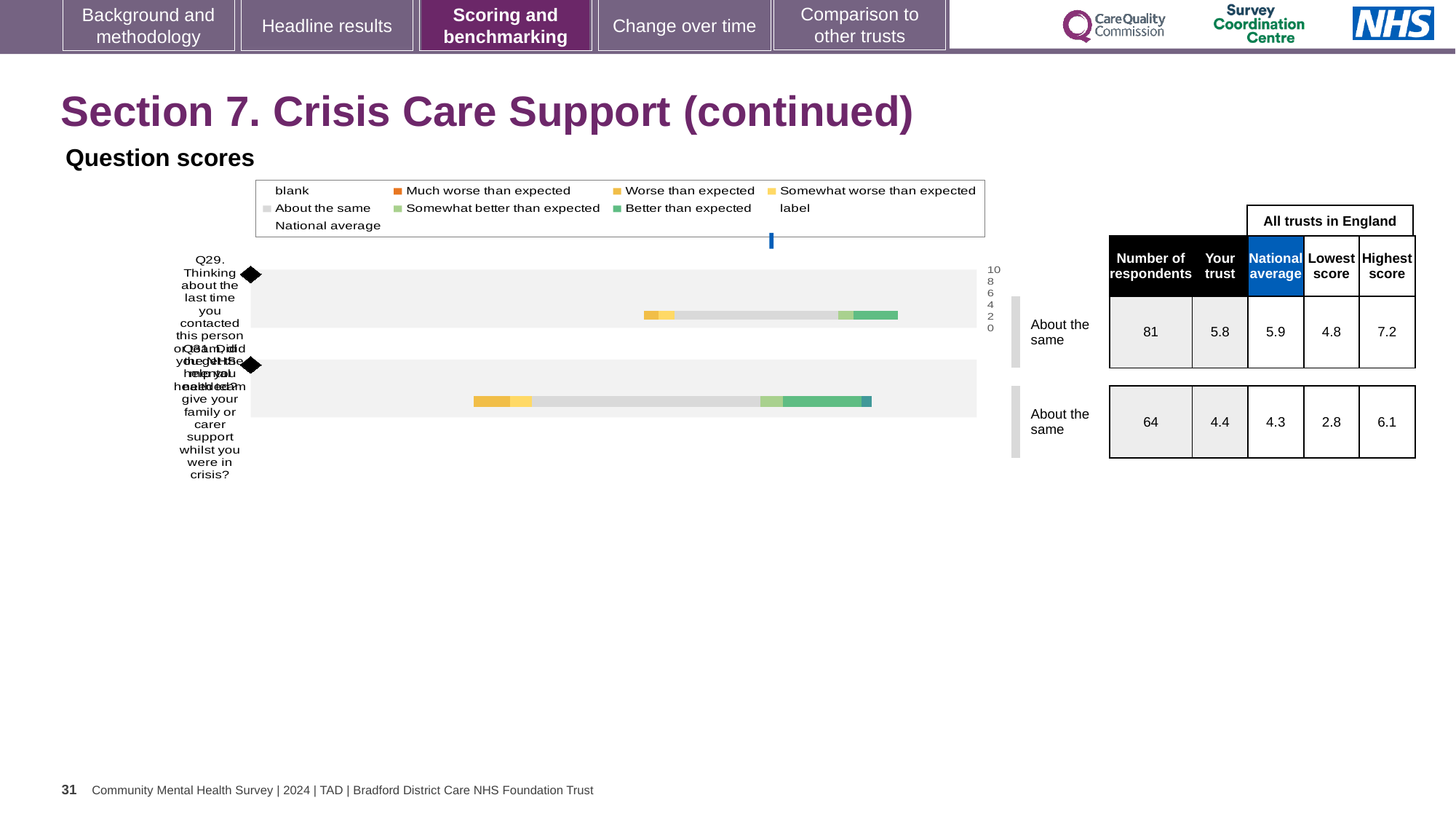
How many questions (bars) are plotted in the question scores chart? 2 According to the table beside the chart, how many respondents answered Q29? 81 According to the table beside the chart, what is the 'Your trust' score for Q29? 5.8 For Q29, which is larger: the 'Your trust' score or the national average? National average What benchmark category is shown for Q31 next to the chart? About the same For Q31, which is larger: the 'Your trust' score or the national average? Your trust What kind of chart is used to show the question scores on this slide? bar chart What is the difference between the highest score and the lowest score for Q29 in the table? 2.4 According to the table beside the chart, what is the highest score among all trusts in England for Q31? 6.1 In the chart legend, what colour represents 'Much worse than expected'? orange Which question is plotted in the top bar of the chart? Q29 According to the table beside the chart, what is the national average for Q31? 4.3